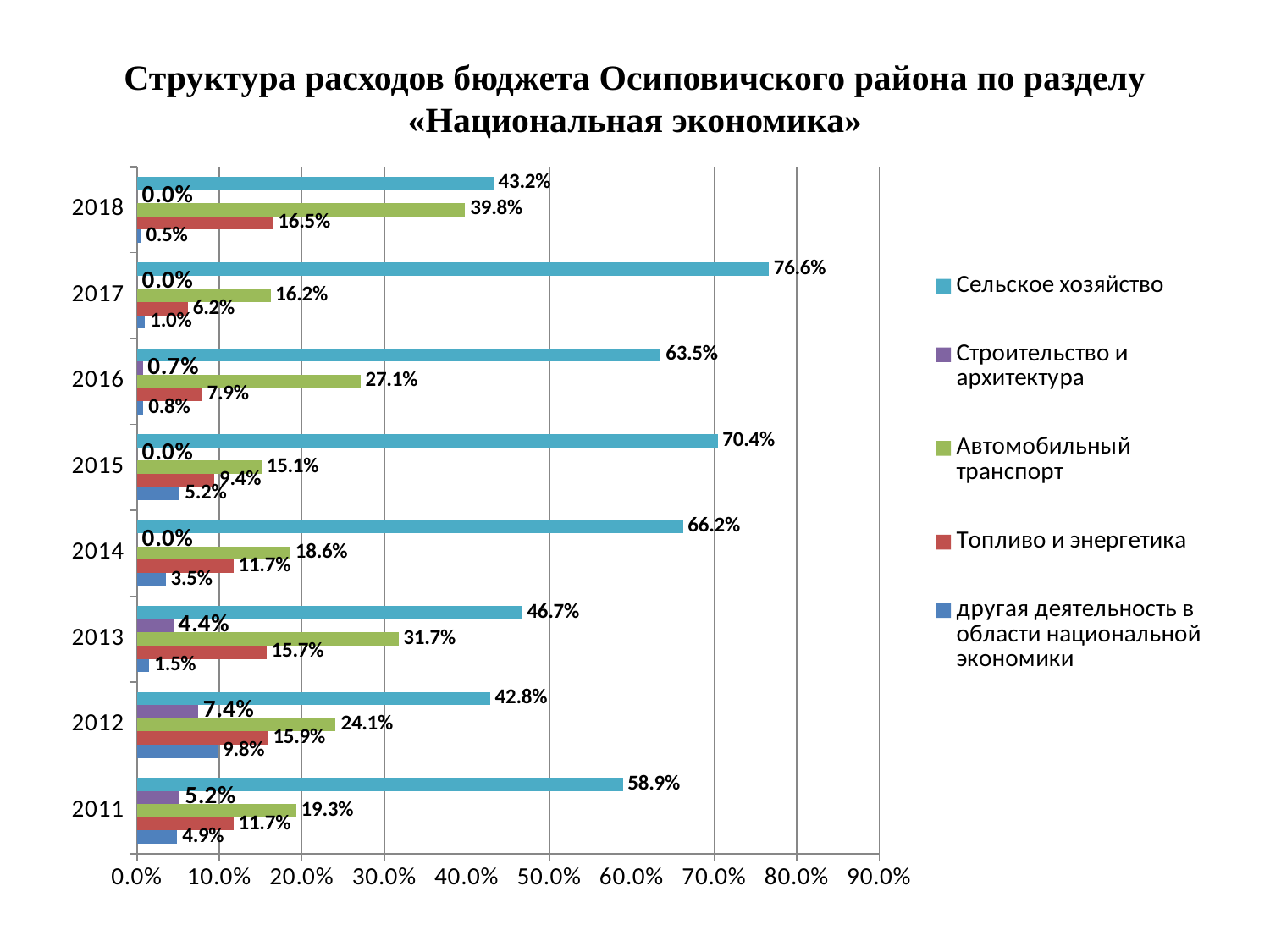
What is the value for Топливо и энергетика in 2013? 15.7% What is the value for другая деятельность в области национальной экономики in 2012? 9.8% What kind of chart is shown on the slide? Bar chart How many series does the legend list? 5 What is the difference between the Сельское хозяйство values for 2017 and 2018? 33.4% How many years are shown on the chart? 8 Which is larger: Автомобильный транспорт in 2013 or in 2012? 2013 What is the value for Автомобильный транспорт in 2018? 39.8% In which year is the value for Сельское хозяйство the highest? 2017 In which year is the value for Автомобильный транспорт the lowest? 2015 What is the value for Сельское хозяйство in 2017? 76.6% Is the value for Сельское хозяйство in 2015 greater or less than 60.0%? greater